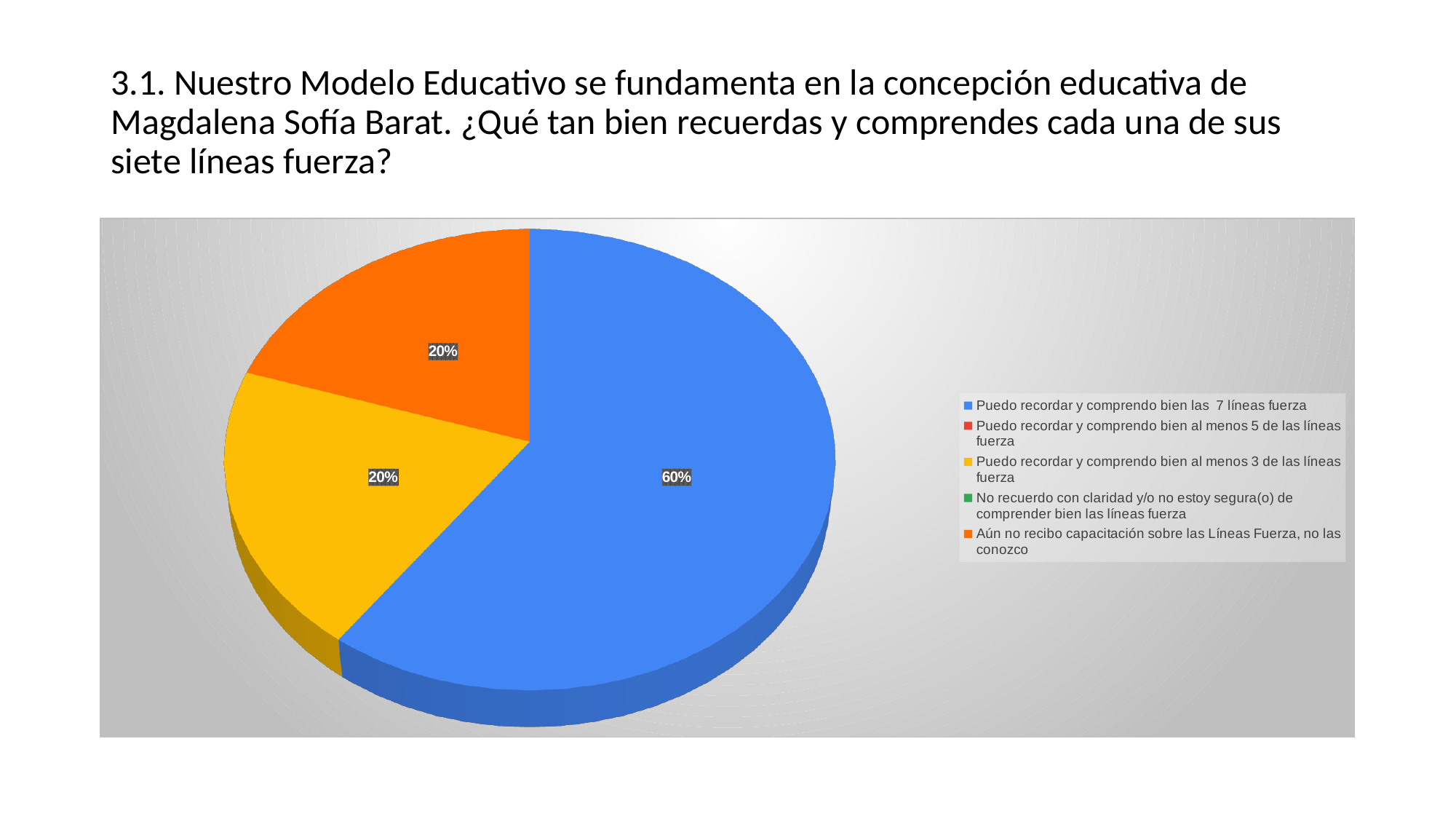
What is the difference between the share for "Puedo recordar y comprendo bien las 7 líneas fuerza" and the share for "Aún no recibo capacitación sobre las Líneas Fuerza, no las conozco"? 40% What share of the pie is the slice for "Puedo recordar y comprendo bien las 7 líneas fuerza"? 60% How many entries does the legend list? 5 What kind of chart is shown on the slide? pie chart What colour is the slice for "Puedo recordar y comprendo bien las 7 líneas fuerza"? blue What share of the pie is the slice for "Puedo recordar y comprendo bien al menos 3 de las líneas fuerza"? 20% Which category has the largest slice of the pie? Puedo recordar y comprendo bien las 7 líneas fuerza What colour is the slice for "Aún no recibo capacitación sobre las Líneas Fuerza, no las conozco"? orange What share of the pie is the slice for "Aún no recibo capacitación sobre las Líneas Fuerza, no las conozco"? 20% Which is larger: the slice for "Puedo recordar y comprendo bien las 7 líneas fuerza" or the slice for "Puedo recordar y comprendo bien al menos 3 de las líneas fuerza"? Puedo recordar y comprendo bien las 7 líneas fuerza How many slices are visible in the pie? 3 Is the share for "Puedo recordar y comprendo bien las 7 líneas fuerza" greater or less than 50%? greater